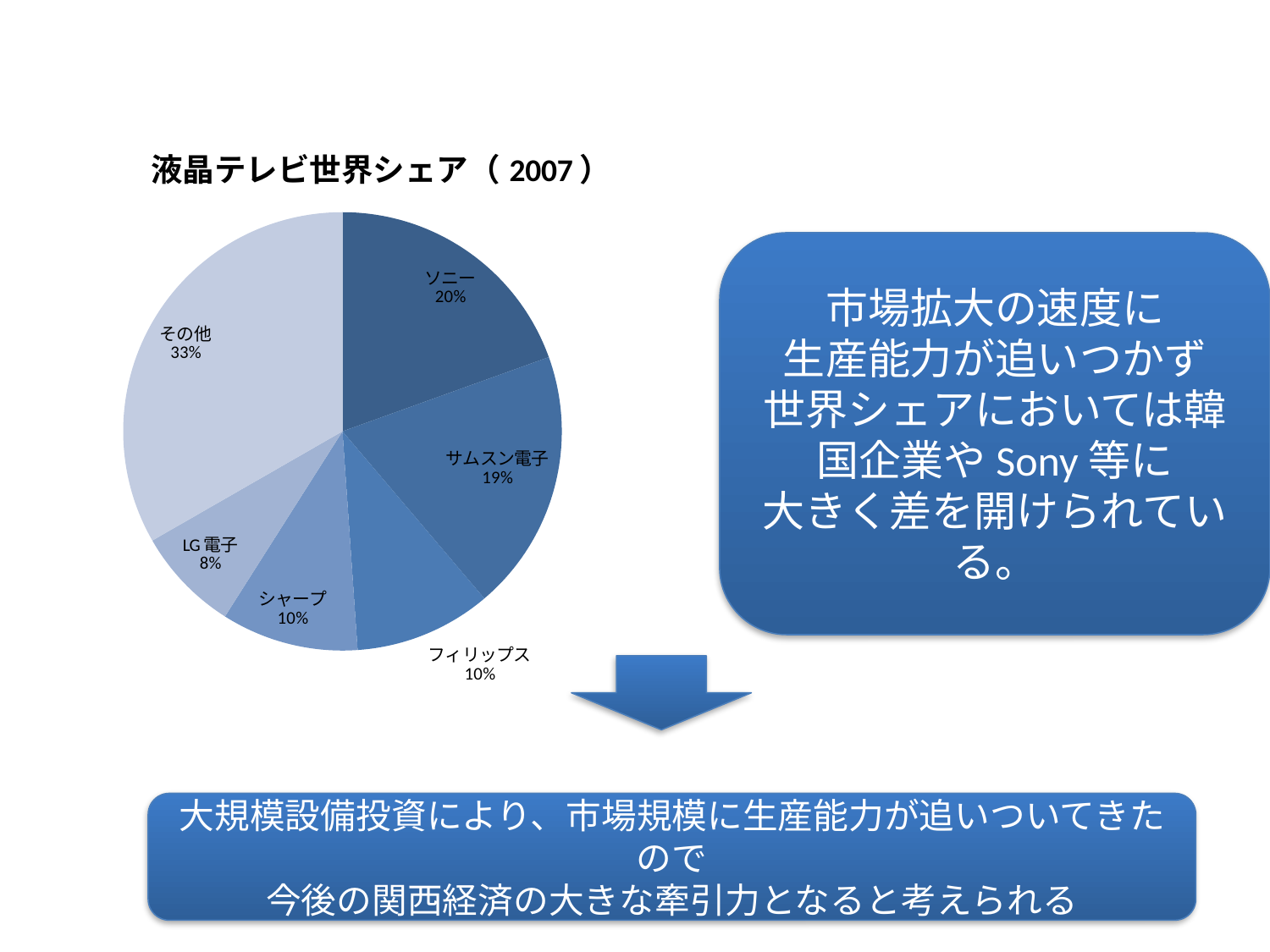
What share does その他 hold in the pie chart? 33% What share does ソニー hold in the pie chart? 20% Which slice of the pie chart is the largest? その他 Which has a larger share, ソニー or サムスン電子? ソニー What is the difference in share between ソニー and LG電子? 12% How many slices does the pie chart have? 6 Which slice of the pie chart is the smallest? LG電子 What is the title of the chart? 液晶テレビ世界シェア（2007） What share does LG電子 hold in the pie chart? 8% What share does サムスン電子 hold in the pie chart? 19% What type of chart is shown on the slide? pie chart What is the combined share of シャープ and フィリップス? 20%